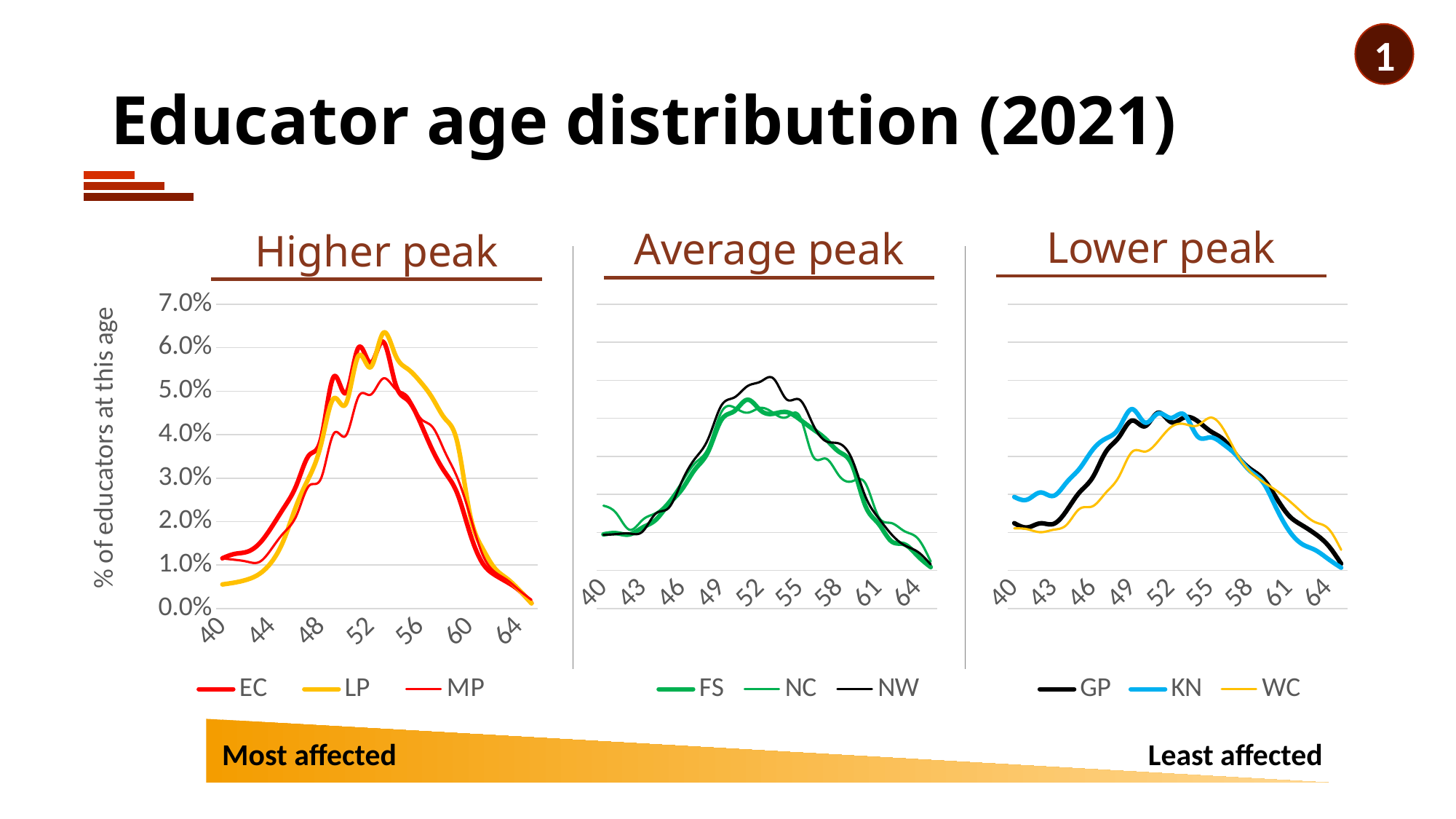
In the "Lower peak" chart, at age 40, which series has the higher value, KN or GP? KN In the "Higher peak" chart, is the peak value of EC greater or less than 5.0%? greater How many series does the legend of the "Average peak" chart list? 3 How many series does the legend of the "Higher peak" chart list? 3 In the "Higher peak" chart, at age 40, which series has the higher value, EC or LP? EC In the "Lower peak" chart, does the KN line rise or fall from age 55 to age 64? Fall In the "Lower peak" chart, is the value for GP at age 40 greater or less than 3.0%? less In the "Higher peak" chart, is the value for LP at age 40 greater or less than 1.0%? less What is the y-axis label of the "Higher peak" chart? % of educators at this age What kind of chart is the "Higher peak" chart? Line chart Which series are listed in the legend of the "Lower peak" chart? GP, KN, WC